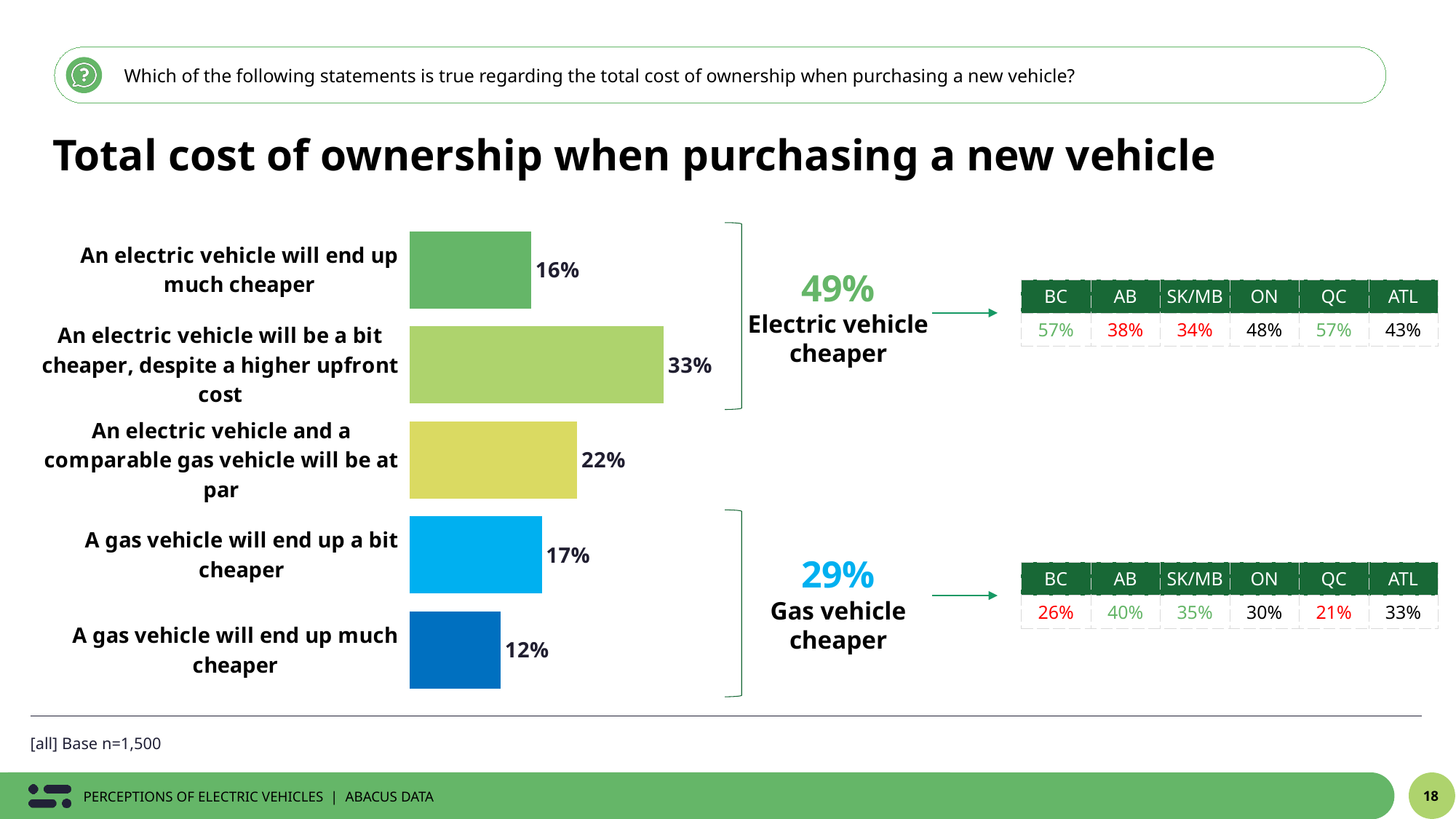
In the 'Electric vehicle cheaper' regional table, what is the value for QC? 57% What percentage of respondents said an electric vehicle will be a bit cheaper, despite a higher upfront cost? 33% What is the combined percentage shown for 'Electric vehicle cheaper'? 49% Which statement received the highest share of responses? An electric vehicle will be a bit cheaper, despite a higher upfront cost What percentage of respondents said a gas vehicle will end up much cheaper? 12% What is the combined percentage shown for 'Gas vehicle cheaper'? 29% What percentage of respondents said an electric vehicle and a comparable gas vehicle will be at par? 22% What kind of chart is used to show the responses? Bar chart What is the difference in percentage points between 'An electric vehicle will end up much cheaper' and 'A gas vehicle will end up much cheaper'? 4 percentage points How many statements (bars) are shown in the chart? 5 Which statement received the lowest share of responses? A gas vehicle will end up much cheaper Which is larger: the share for 'A gas vehicle will end up a bit cheaper' or 'An electric vehicle will end up much cheaper'? A gas vehicle will end up a bit cheaper